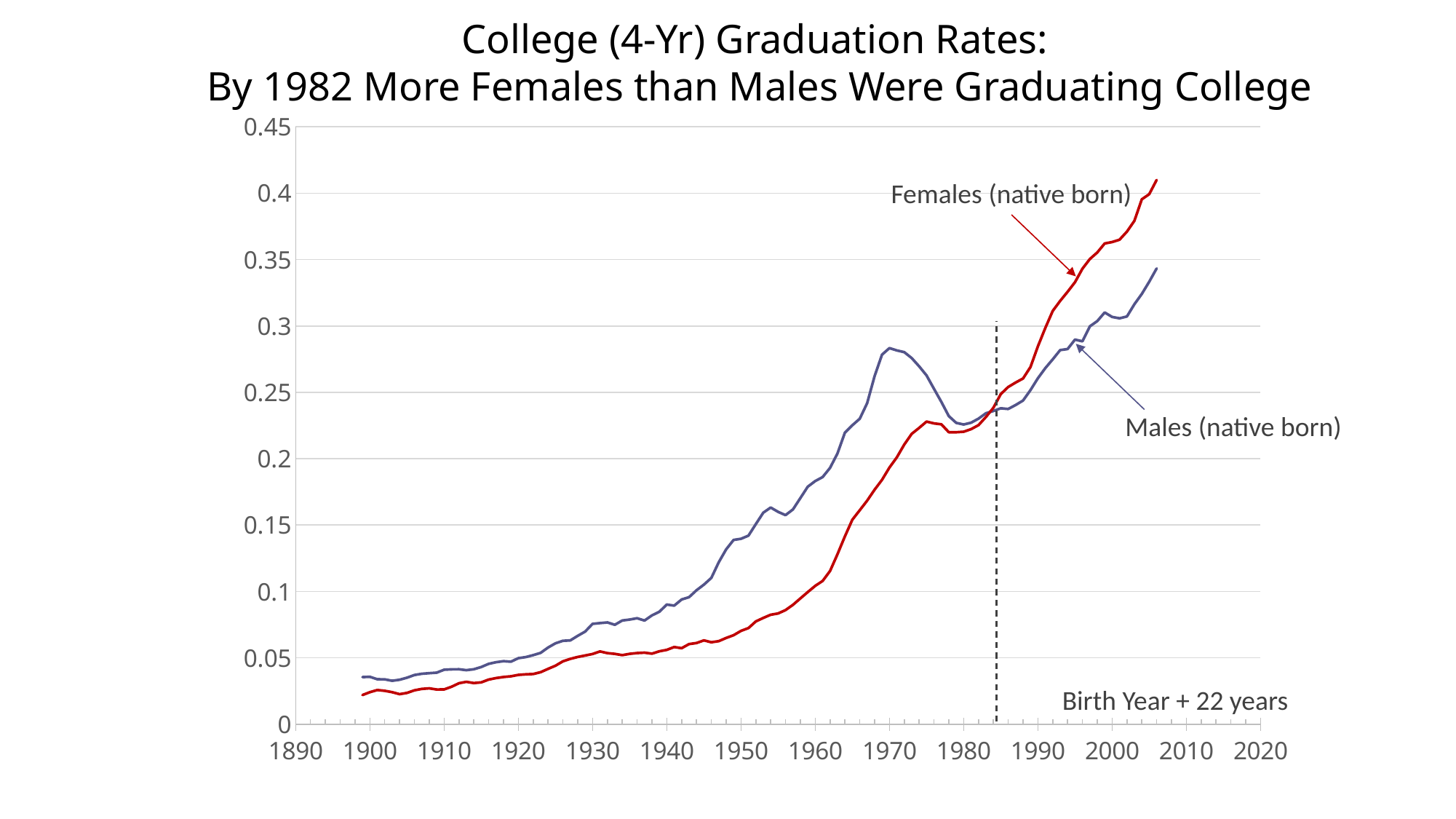
At 1970, which series has the higher value, Females (native born) or Males (native born)? Males (native born) Is the value for Males (native born) at 1970 greater or less than 0.25? greater What colour is the Females (native born) line? red Is the value for Females (native born) at 1970 greater or less than 0.2? less At 2000, which series has the higher value, Females (native born) or Males (native born)? Females (native born) Is the final value of the Females (native born) line, around 2006, greater or less than 0.4? greater How many series are plotted on the chart? 2 What kind of chart is shown on the slide? line chart What are the names of the two series plotted on the chart? Females (native born) and Males (native born) Does the Males (native born) line rise or fall between 1970 and 1980? fall